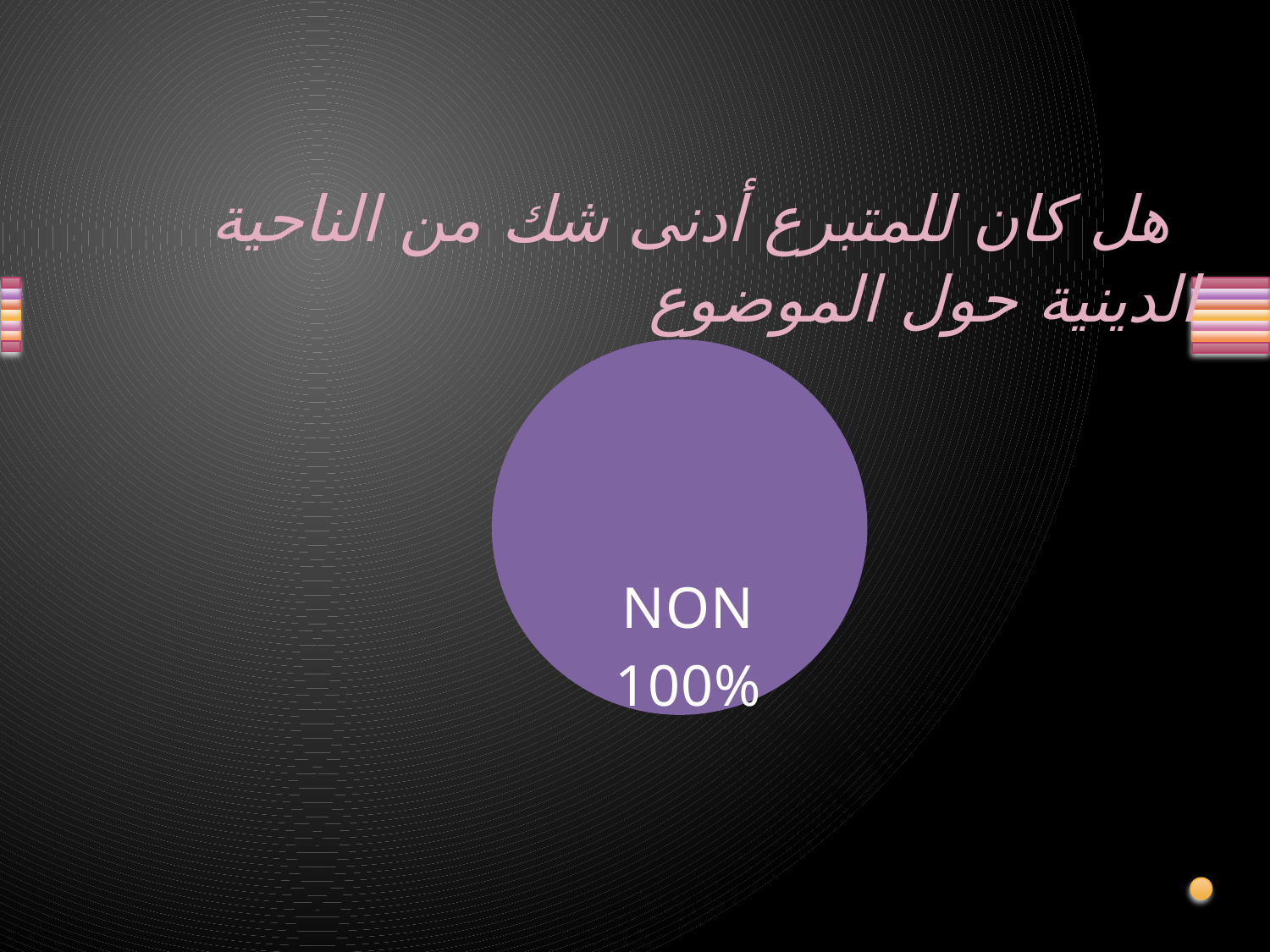
Which category has the largest share of the pie chart? NON What share of the pie does the NON slice represent? 100% What kind of chart is shown on the slide? pie chart What is the value printed on the NON slice of the pie chart? 100% How many slices does the pie chart have? 1 What colour is the NON slice of the pie chart? purple Is the share for NON greater or less than 50%? greater What is the label of the only slice in the pie chart? NON